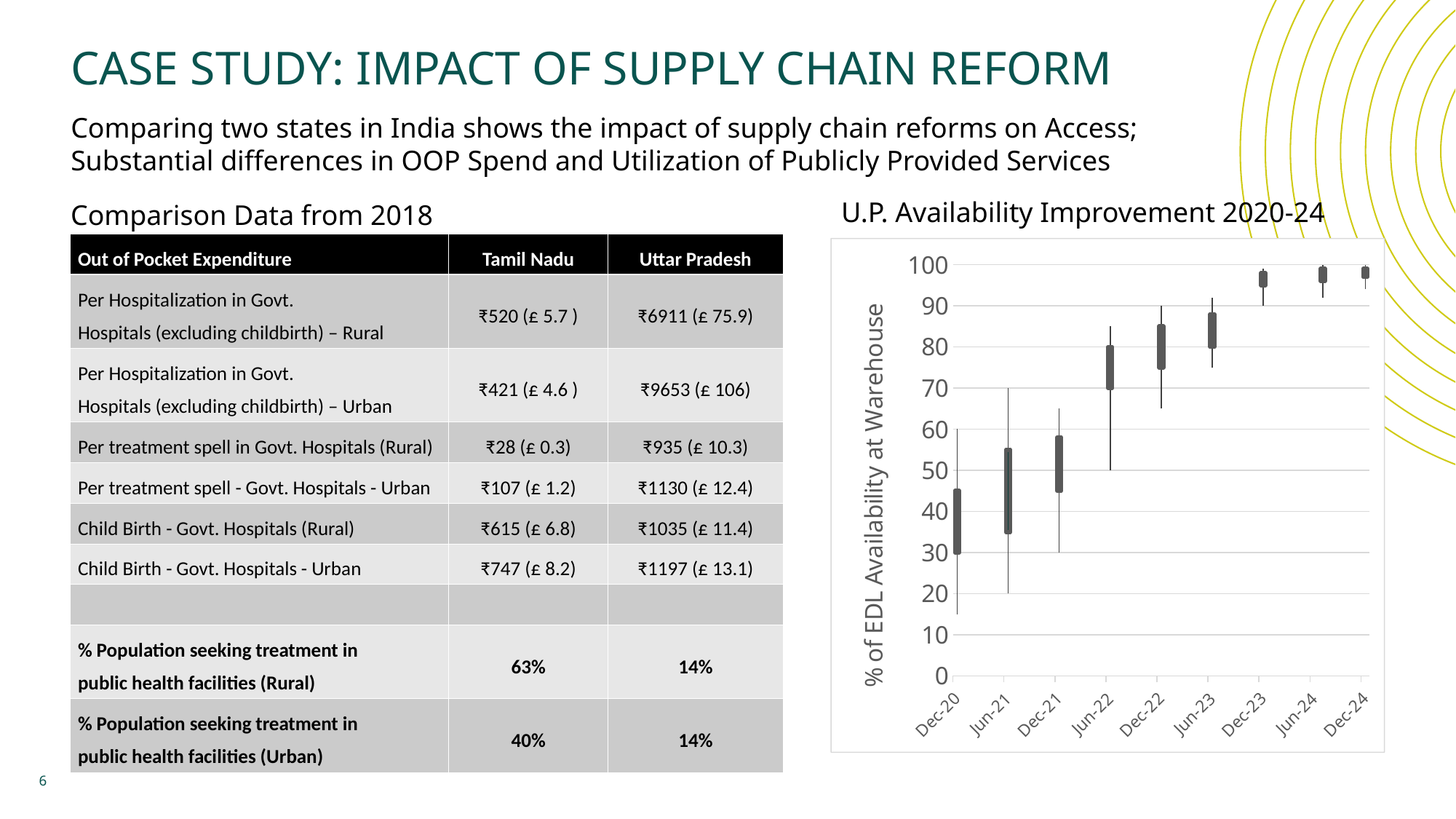
In the 'U.P. Availability Improvement 2020-24' chart, which is higher: Dec-22 or Dec-20? Dec-22 What is the y-axis label of the 'U.P. Availability Improvement 2020-24' chart? % of EDL Availability at Warehouse What is the title of the chart on the right of the slide? U.P. Availability Improvement 2020-24 In the 'U.P. Availability Improvement 2020-24' chart, is the value for Jun-22 greater or less than 60? greater How many time periods are shown on the x axis of the 'U.P. Availability Improvement 2020-24' chart? 9 In the 'U.P. Availability Improvement 2020-24' chart, which is higher: Jun-21 or Jun-23? Jun-23 What kind of chart is the 'U.P. Availability Improvement 2020-24' chart? Box-and-whisker chart In the 'U.P. Availability Improvement 2020-24' chart, do the values rise or fall from Dec-20 to Dec-24? Rise In the 'U.P. Availability Improvement 2020-24' chart, which period has the lowest availability? Dec-20 In the 'U.P. Availability Improvement 2020-24' chart, is the value for Dec-22 greater or less than 70? greater In the 'U.P. Availability Improvement 2020-24' chart, is the value for Dec-24 greater or less than 90? greater